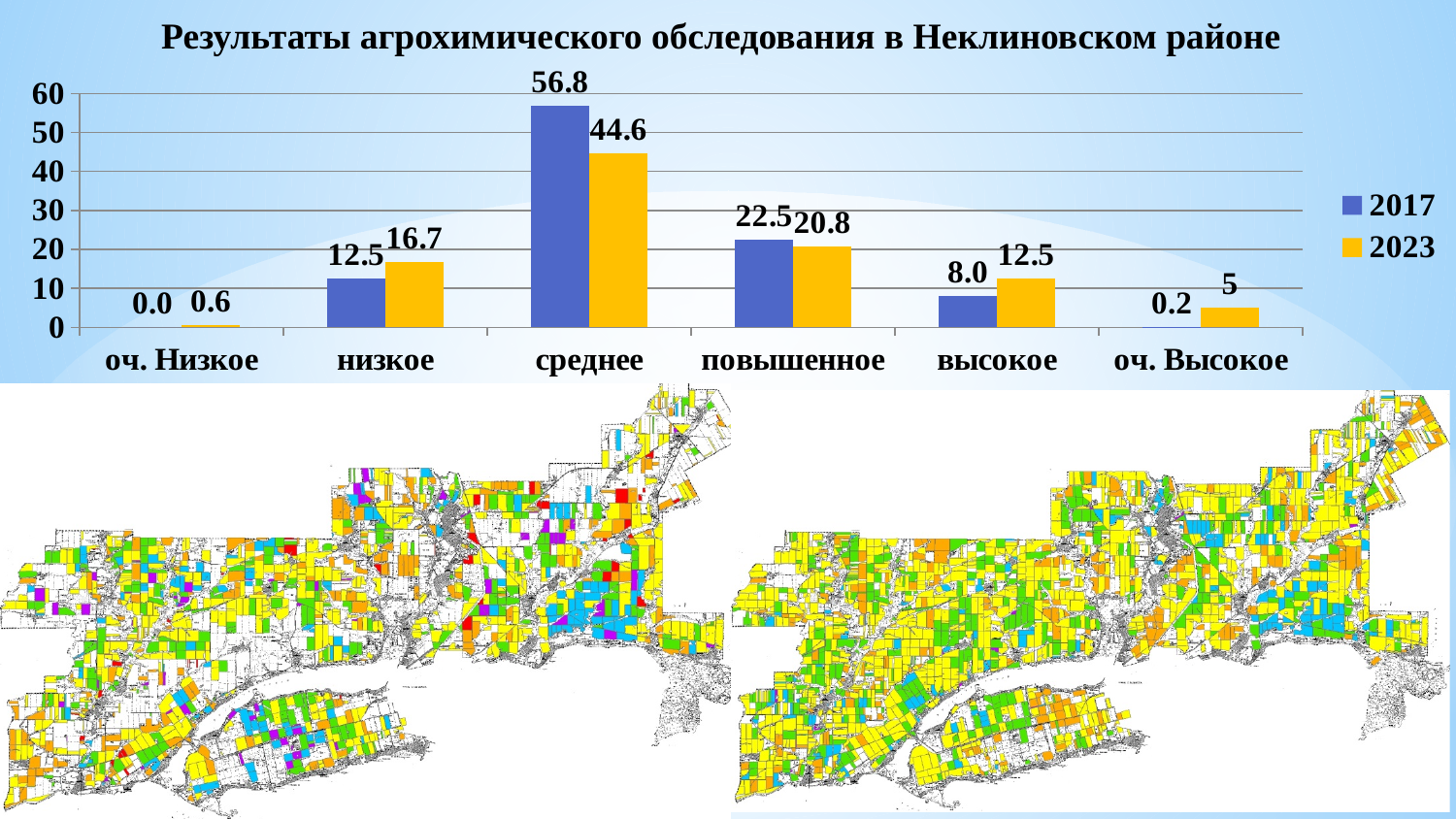
What is the title of the chart? Результаты агрохимического обследования в Неклиновском районе How many categories are shown on the x axis of the chart? 6 What is the value for 2023 in the "оч. Высокое" category? 5 What type of chart is shown on the slide? bar chart What is the value for 2017 in the "среднее" category? 56.8 What is the difference between the 2017 and 2023 values in the "среднее" category? 12.2 Which category has the lowest value for the 2017 series? оч. Низкое What is the value for 2023 in the "низкое" category? 16.7 What is the value for 2017 in the "высокое" category? 8.0 Which category has the highest value for the 2023 series? среднее Which is larger in the "повышенное" category: the 2017 value or the 2023 value? 2017 How many series does the legend list? 2